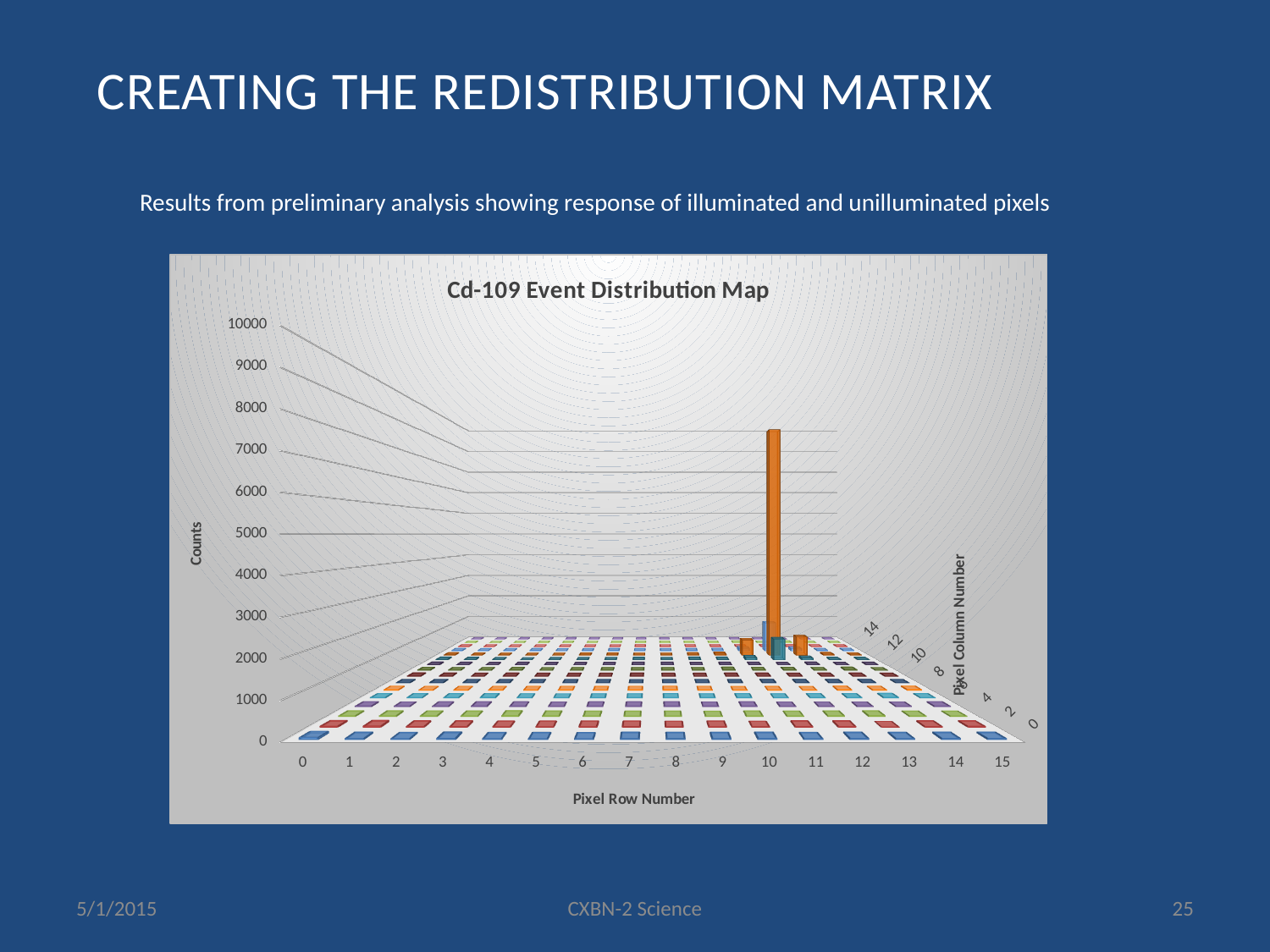
Is the tallest bar in the chart greater or less than 4000 counts? greater What is the highest value shown on the Counts axis of the chart? 10000 Are the bars for pixel row number 0 greater or less than 1000 counts? less What kind of chart is shown on the slide? bar chart What is the highest pixel row number shown on the x axis of the chart? 15 How many pixel row numbers are shown along the x axis of the chart? 16 What is the lowest pixel row number shown on the x axis of the chart? 0 What is the label of the vertical axis of the chart? Counts Which pixel row number has the tallest bar in the chart? 12 What is the title of the chart? Cd-109 Event Distribution Map